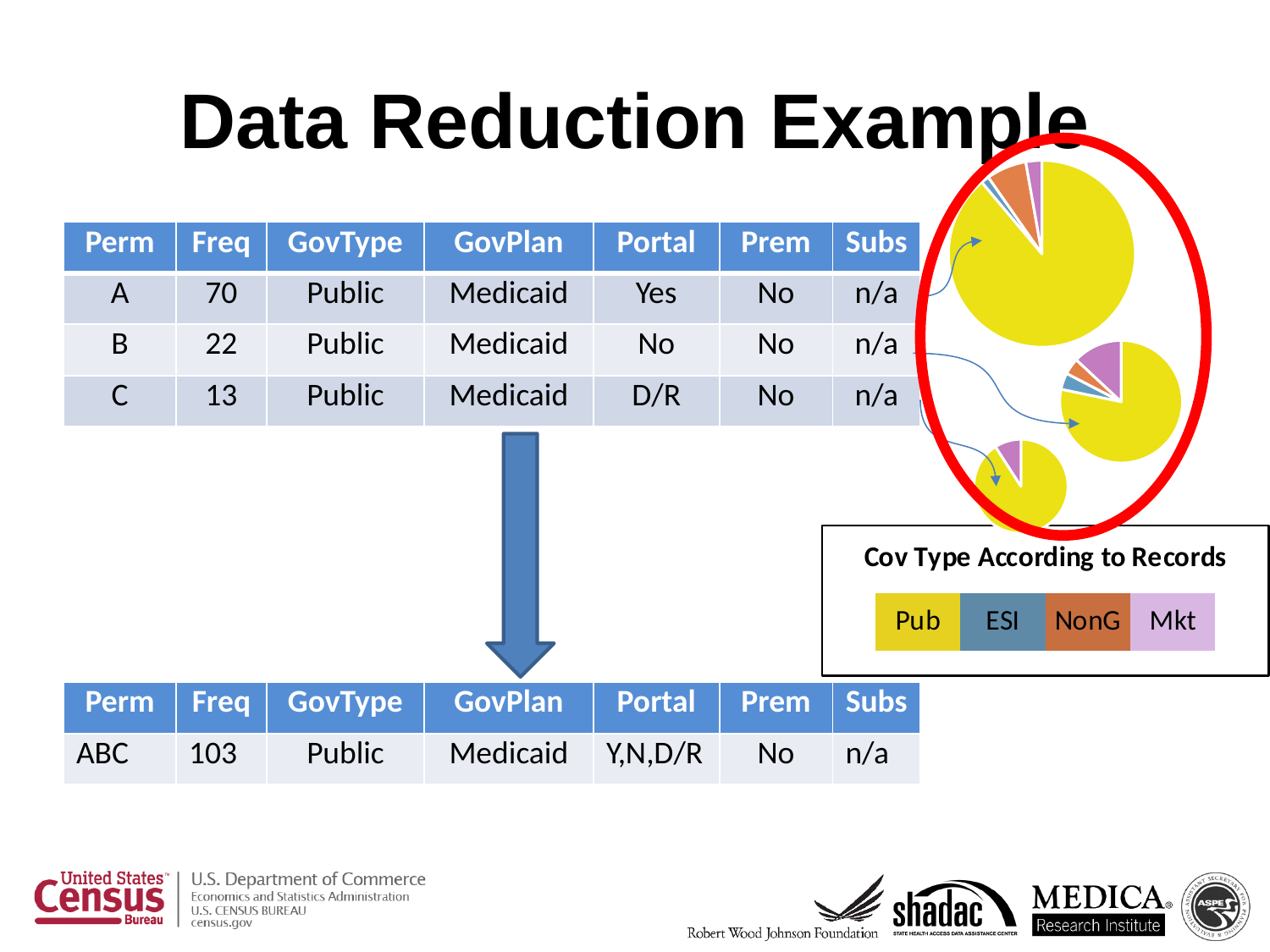
How many pie charts are shown in the circled area of the slide? 3 In the top pie chart, which slice is larger, Pub or ESI? Pub In the middle (right) pie chart, which slice is larger, Pub or Mkt? Pub What kind of chart is used in the circled area of the slide? pie chart How many categories does the 'Cov Type According to Records' legend list? 4 In the largest (top) pie chart, which coverage type has the largest slice? Pub What colour represents Pub in the pie chart legend? yellow In the middle (right) pie chart, which coverage type has the largest slice? Pub In the smallest (bottom-left) pie chart, which coverage type has the largest slice? Pub In the top pie chart, which slice is larger, NonG or ESI? NonG What is the title of the legend for the pie charts? Cov Type According to Records